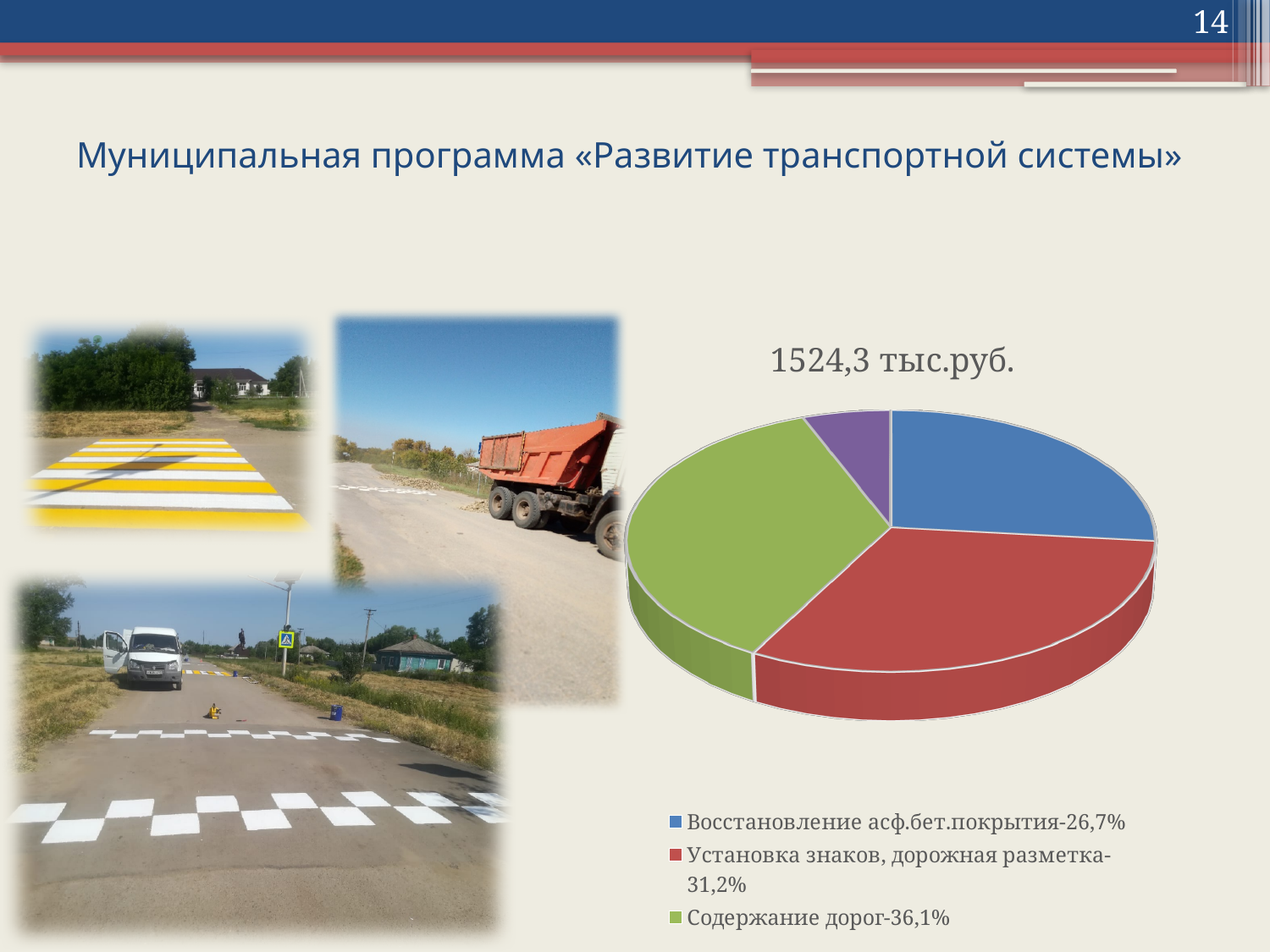
What kind of chart is shown on the slide? Pie chart What is the title of the pie chart? 1524,3 тыс.руб. What colour is the slice for Содержание дорог? Green Of the three categories listed in the legend, which has the smallest share? Восстановление асф.бет.покрытия Which is larger: the share of Установка знаков, дорожная разметка or the share of Восстановление асф.бет.покрытия? Установка знаков, дорожная разметка What share of the pie does Установка знаков, дорожная разметка have? 31,2% What share of the pie does Содержание дорог have? 36,1% How many slices does the pie chart have? 4 What share of the pie does Восстановление асф.бет.покрытия have? 26,7% By how many percentage points does the share of Содержание дорог exceed that of Восстановление асф.бет.покрытия? 9,4 percentage points By how many percentage points does the share of Установка знаков, дорожная разметка exceed that of Восстановление асф.бет.покрытия? 4,5 percentage points Which category has the largest share of the pie? Содержание дорог